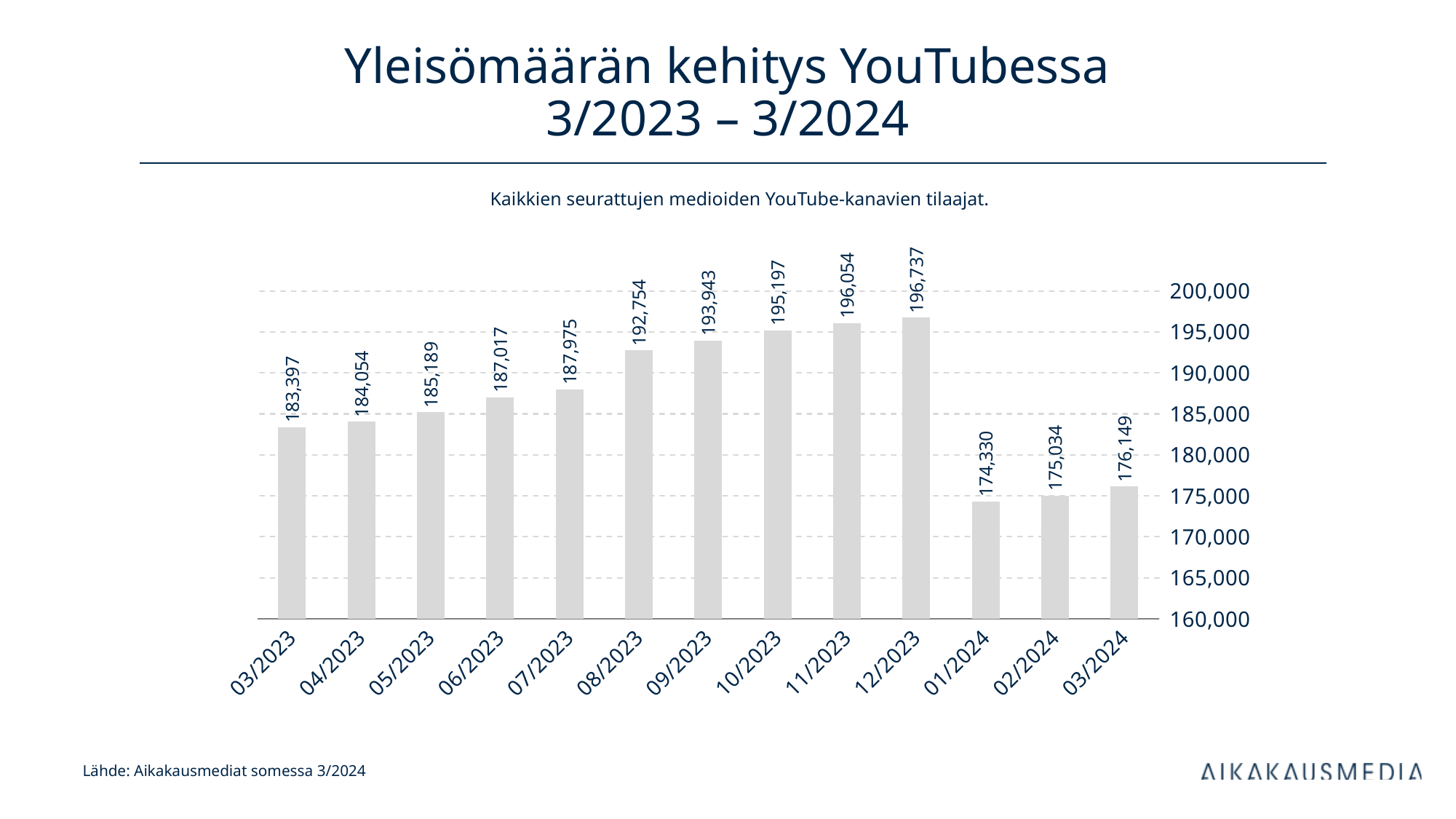
What is the value for 01/2024? 174,330 How many months are shown on the x axis? 13 Do the values rise or fall from 03/2023 to 12/2023? rise What is the value for 12/2023? 196,737 Which is larger, the value for 08/2023 or the value for 02/2024? 08/2023 What is the difference between the values for 12/2023 and 01/2024? 22,407 What is the value for 03/2023? 183,397 What is the value for 03/2024? 176,149 What kind of chart is this? bar chart What is the difference between the values for 03/2024 and 03/2023? 7,248 Which month has the lowest value? 01/2024 Which month has the highest value? 12/2023